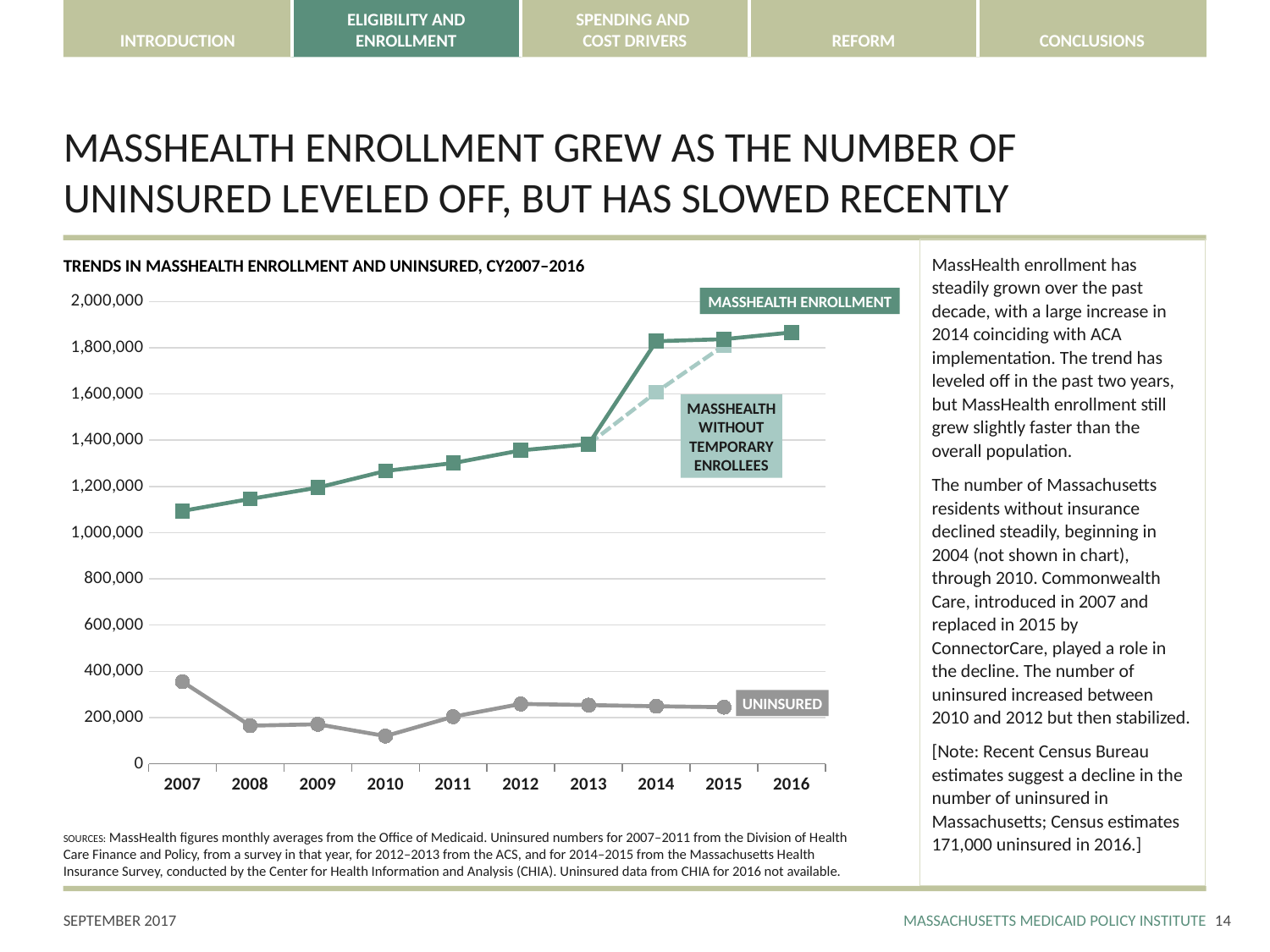
In which year is the Uninsured series at its lowest? 2010 What kind of chart is shown on the slide? Line chart Is the Uninsured value for 2010 greater or less than 200,000? less Is the MassHealth Enrollment value for 2016 greater or less than 1,800,000? greater In which year is the Uninsured series at its highest? 2007 Is the MassHealth Enrollment value for 2007 greater or less than 1,200,000? less Does MassHealth Enrollment generally rise or fall from 2007 to 2016? Rise In which year is MassHealth Enrollment at its lowest? 2007 How many years are shown along the x axis of the chart? 10 Which year has the larger MassHealth Enrollment value, 2013 or 2014? 2014 What is the title of the chart? Trends in MassHealth Enrollment and Uninsured, CY2007–2016 How many data series are labeled on the chart? 3